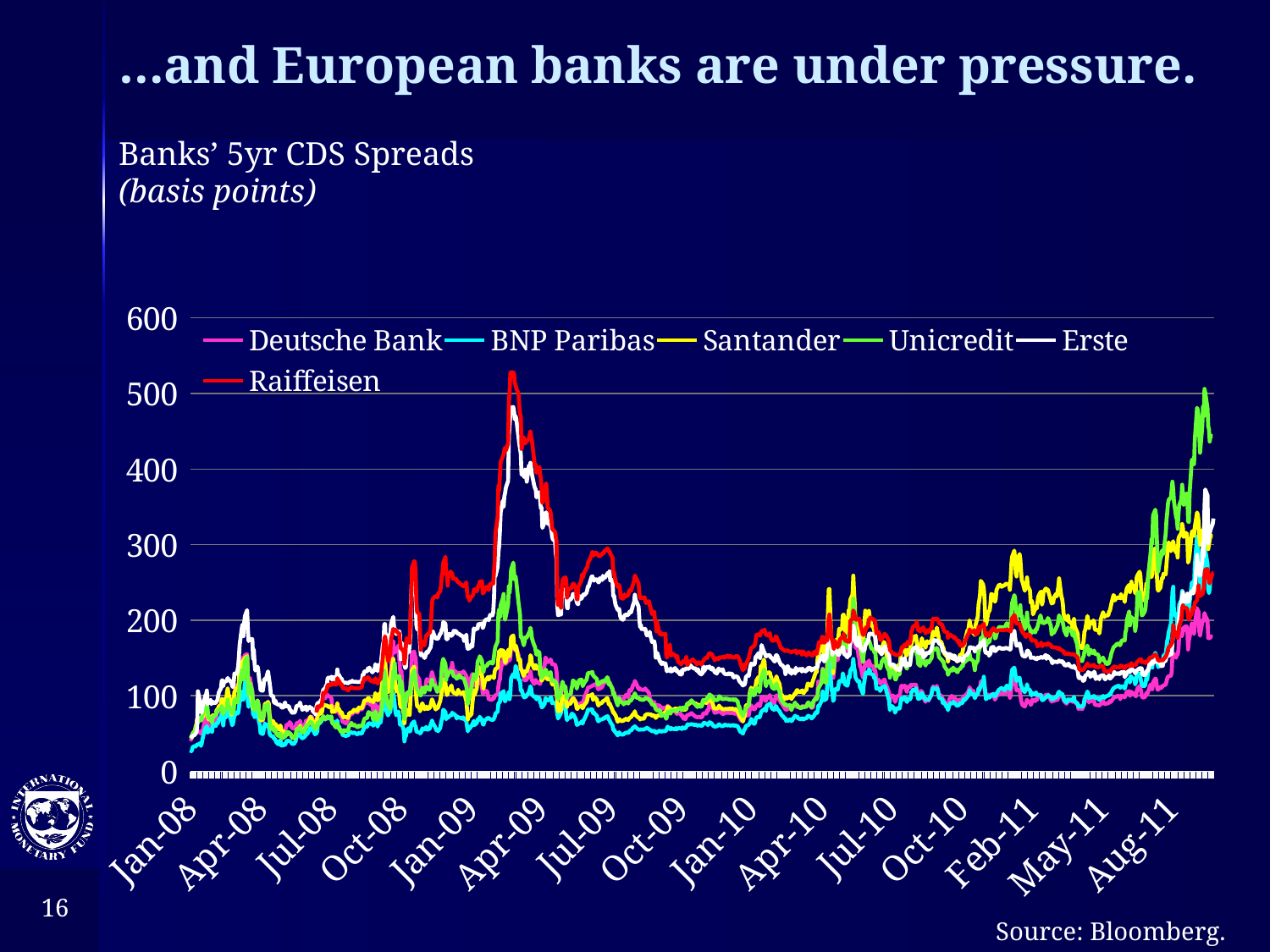
Is the peak value for Unicredit near the end of the series greater or less than 400? greater Is the value for BNP Paribas in Jan-08 greater or less than 100? less How many date labels are shown on the x axis? 15 Which banks are listed in the chart legend? Deutsche Bank, BNP Paribas, Santander, Unicredit, Erste, Raiffeisen In what units are the CDS spreads shown? Basis points What kind of chart is shown on the slide? Line chart Which bank has the highest CDS spread at the end of the series (after Aug-11)? Unicredit Which bank's CDS spread reaches the highest peak around Apr-09? Raiffeisen How many series does the legend list? 6 Do the CDS spreads generally rise or fall between May-11 and Aug-11? Rise Is the peak value for Raiffeisen around Apr-09 greater or less than 400? greater Which bank has the lowest CDS spread at the end of the series (after Aug-11)? Deutsche Bank